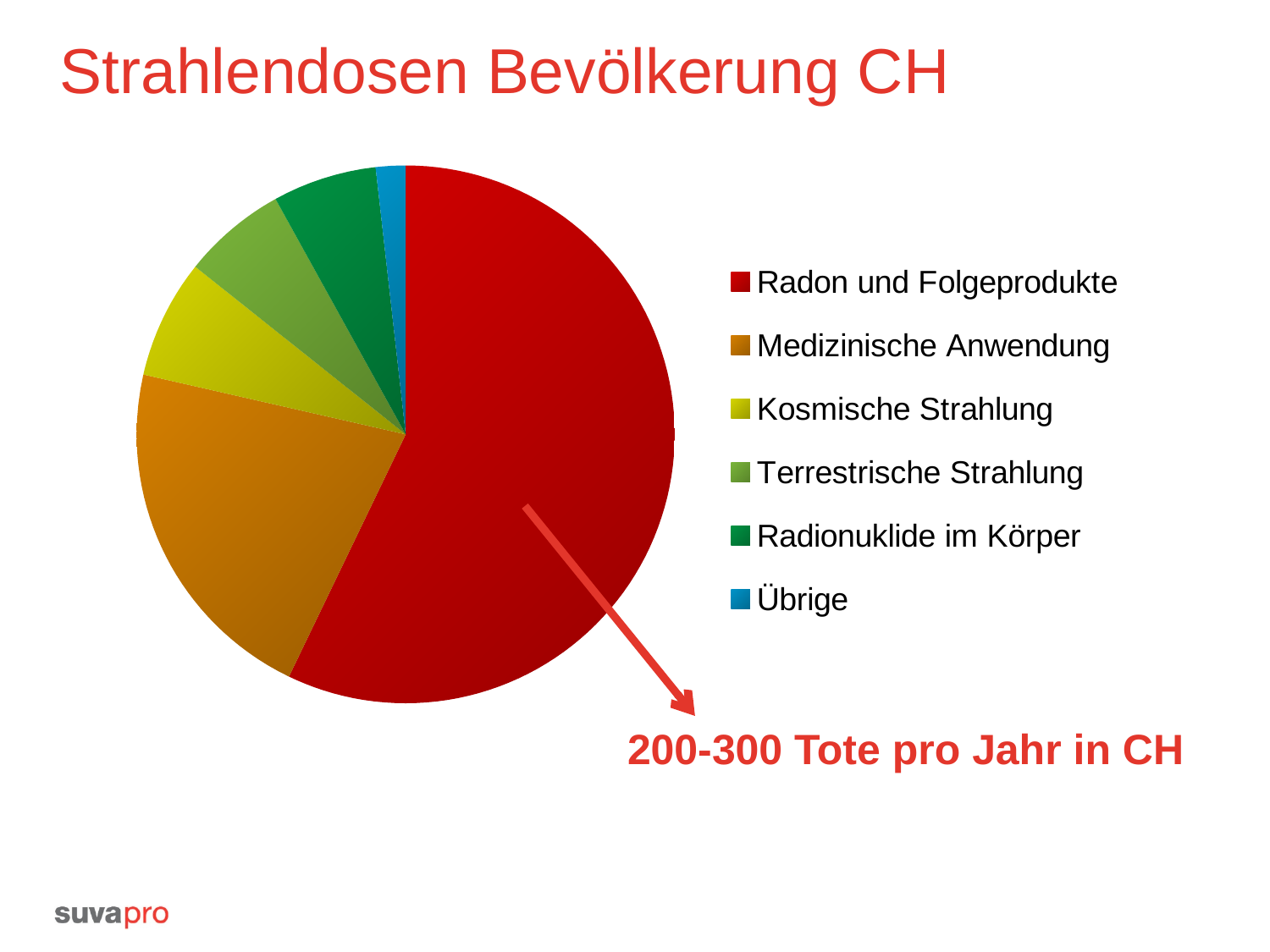
Which category has the second-largest slice of the pie chart? Medizinische Anwendung Which category has the smallest slice of the pie chart? Übrige Which category has the largest slice of the pie chart? Radon und Folgeprodukte How many categories (slices) does the pie chart have? 6 Which slice is larger: Radon und Folgeprodukte or Medizinische Anwendung? Radon und Folgeprodukte Which colour represents Medizinische Anwendung in the pie chart? orange Which slice is larger: Radionuklide im Körper or Übrige? Radionuklide im Körper Which slice is larger: Medizinische Anwendung or Kosmische Strahlung? Medizinische Anwendung What kind of chart is shown on the slide? pie chart What is the title of the slide containing the pie chart? Strahlendosen Bevölkerung CH